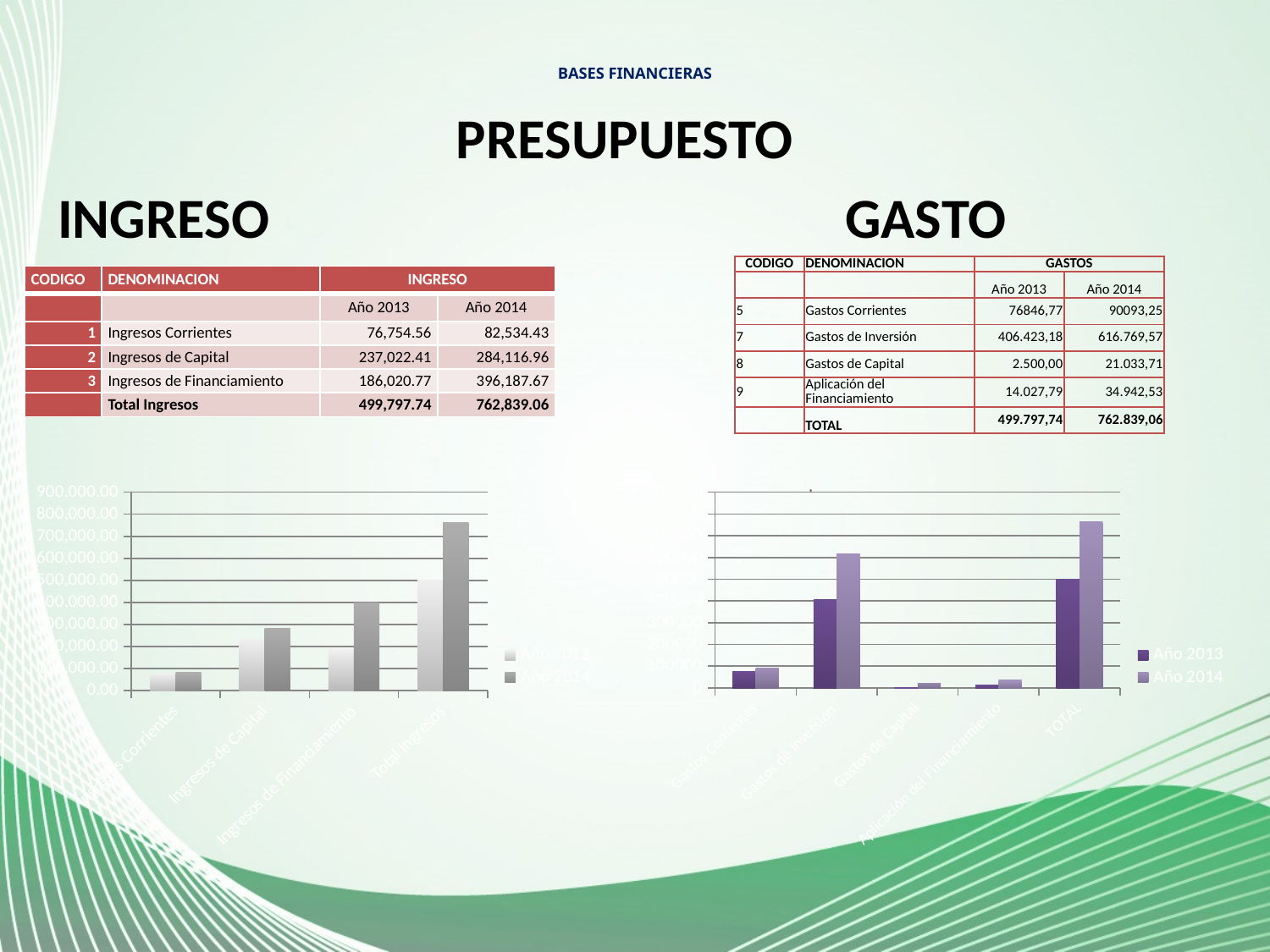
How many categories are shown on the x axis of the GASTO chart? 5 In the GASTO chart, which category has the lowest Año 2013 value? Gastos de Capital In the INGRESO chart, is the Año 2014 value for Ingresos de Capital greater or less than 200,000.00? greater In the INGRESO chart, is the Año 2013 value for Ingresos Corrientes greater or less than 100,000.00? less How many categories are shown on the x axis of the INGRESO chart? 4 In the GASTO chart, is the Año 2014 value for Gastos de Inversión greater or less than 500000? greater In the INGRESO chart, which category has the lowest Año 2013 value? Ingresos Corrientes In the INGRESO chart, which category has the highest Año 2014 value? Total Ingresos In the GASTO chart, which is larger for Gastos de Inversión: Año 2013 or Año 2014? Año 2014 How many series does the legend of the INGRESO chart list? 2 What kind of chart is the chart under the INGRESO heading? bar chart